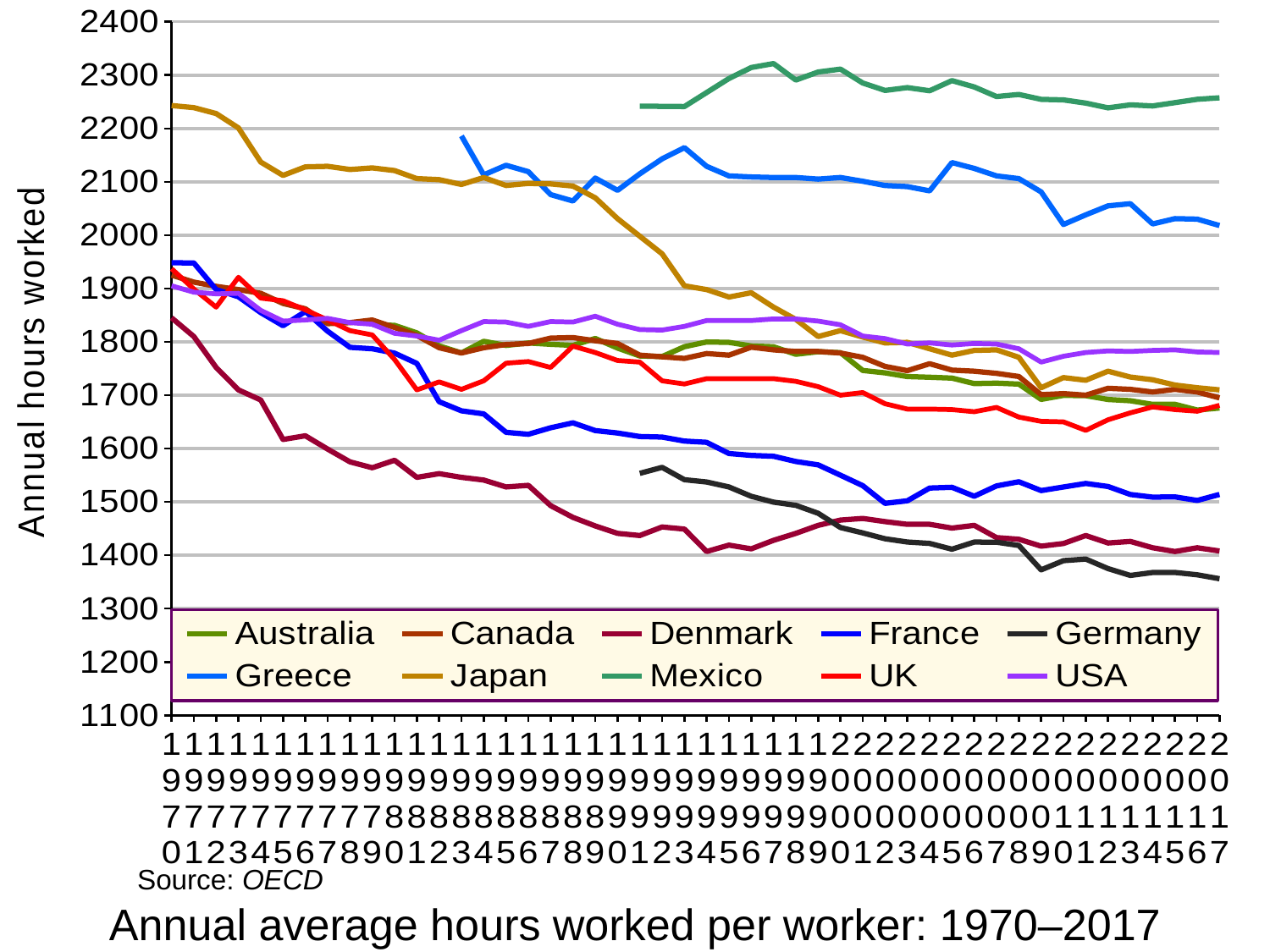
Which country has the lowest annual hours worked in 2017? Germany Which country has the highest annual hours worked in 1970? Japan Which country has the highest annual hours worked in 2017? Mexico Do the annual hours worked for Denmark rise or fall from 1970 to 2017? fall What is the title of the chart? Annual average hours worked per worker: 1970–2017 What is the label on the vertical axis? Annual hours worked How many series does the legend list? 10 Is the value for Japan in 1970 greater or less than 2200? greater Is the value for Germany in 2017 greater or less than 1400? less In 2017, which has more annual hours worked, Greece or USA? Greece What kind of chart is shown on the slide? line chart Do the annual hours worked for Japan rise or fall from 1970 to 2017? fall